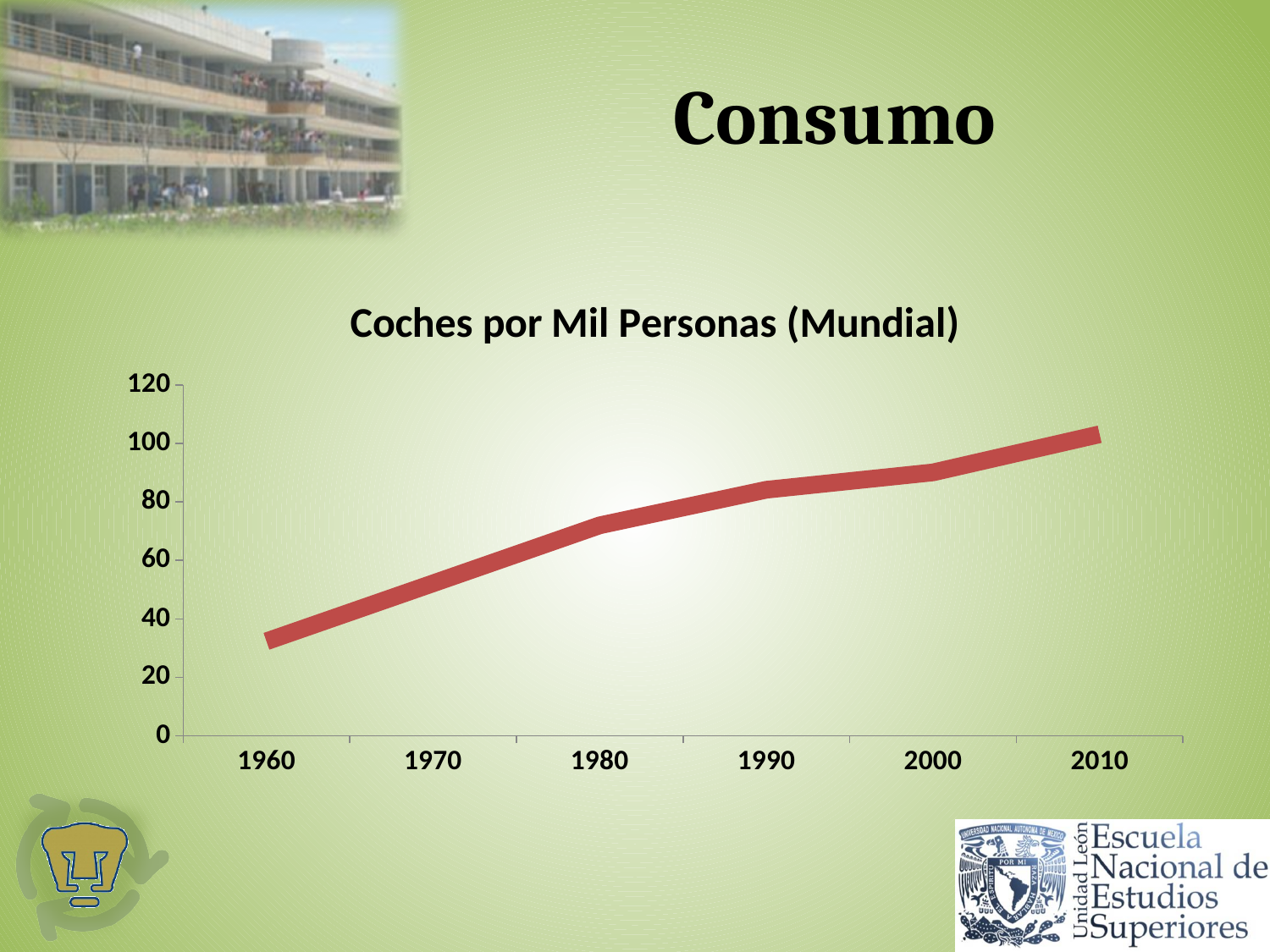
Which year has the lowest value on the chart? 1960 Which is larger, the value for 1980 or the value for 1960? 1980 How many years are plotted along the x axis of the chart? 6 What is the title of the chart? Coches por Mil Personas (Mundial) Which year has the highest value on the chart? 2010 Is the value for 2010 greater or less than 80? greater Is the value for 1960 greater or less than 40? less Do the values rise or fall from 1960 to 2010? rise Is the value for 1970 greater or less than 40? greater What kind of chart is shown on the slide? line chart